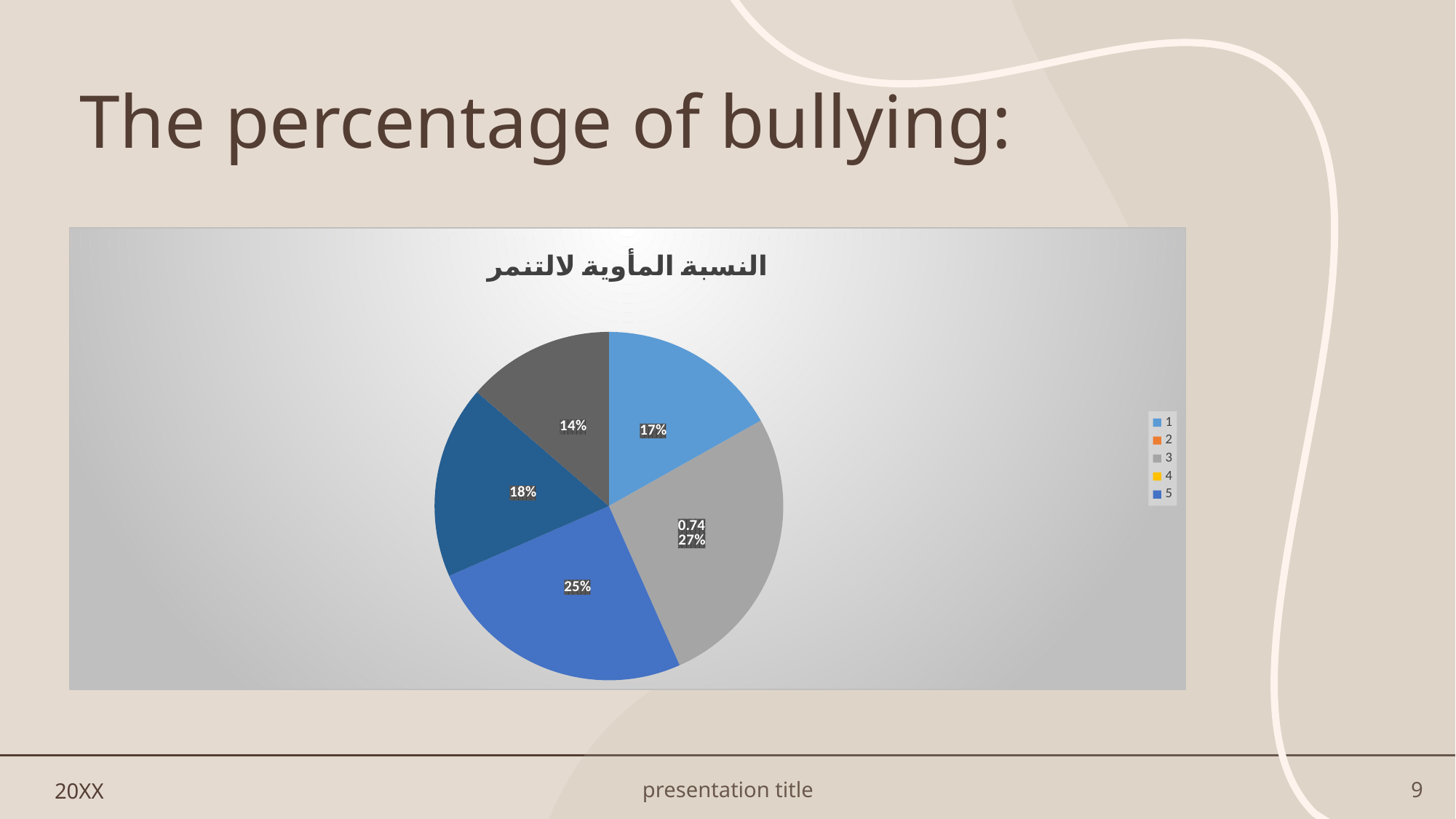
What percentage is labelled on the dark gray slice of the pie chart? 14% How many entries does the legend of the pie chart list? 5 What kind of chart is shown on the slide? pie chart Which is larger on the pie chart: the slice labelled 25% or the slice labelled 18%? the slice labelled 25% Besides the percentage, what additional value is printed on the 27% slice of the pie chart? 0.74 What is the largest percentage labelled on the pie chart? 27% How many slices does the pie chart have? 5 What is the title of the slide containing the pie chart? The percentage of bullying: What is the smallest percentage labelled on the pie chart? 14% What percentage is labelled on the light blue slice of the pie chart? 17% What is the difference in percentage points between the largest slice (27%) and the smallest slice (14%) of the pie chart? 13 percentage points What percentage is labelled on the light gray slice of the pie chart? 27%